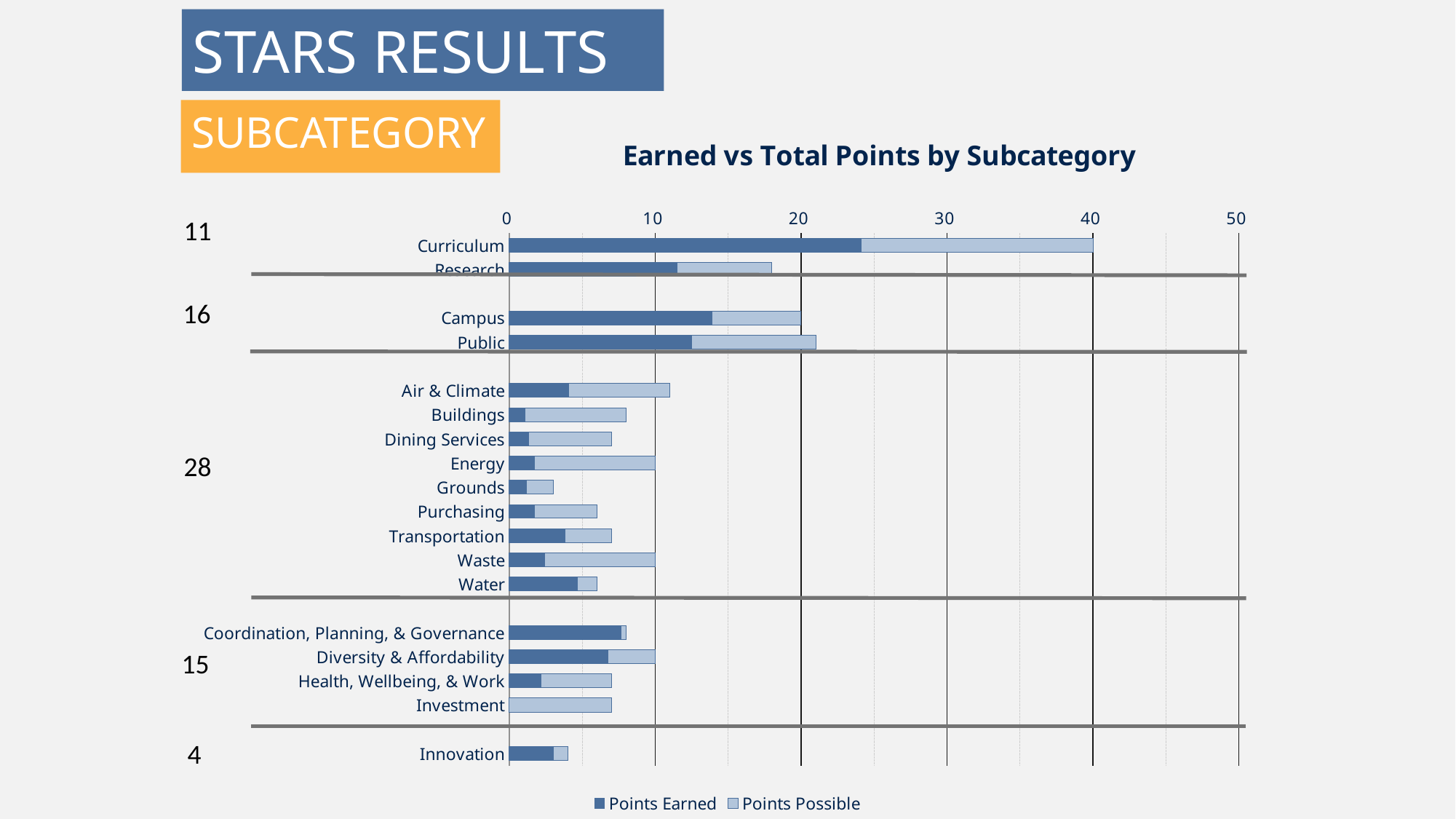
What are the two series named in the legend? Points Earned and Points Possible At what axis value does the full Curriculum bar end? 40 How many subcategories are plotted on the chart? 18 What kind of chart is shown on the slide? bar chart Which subcategory has the longest total bar? Curriculum Which subcategory has the smallest Points Earned segment? Investment Is the Points Earned value for Curriculum greater or less than 20? greater At what axis value does the full Campus bar end? 20 Is the total bar length for Grounds greater or less than 10? less Which has a larger Points Earned segment, Air & Climate or Buildings? Air & Climate What is the title of the chart? Earned vs Total Points by Subcategory How many series does the legend list? 2